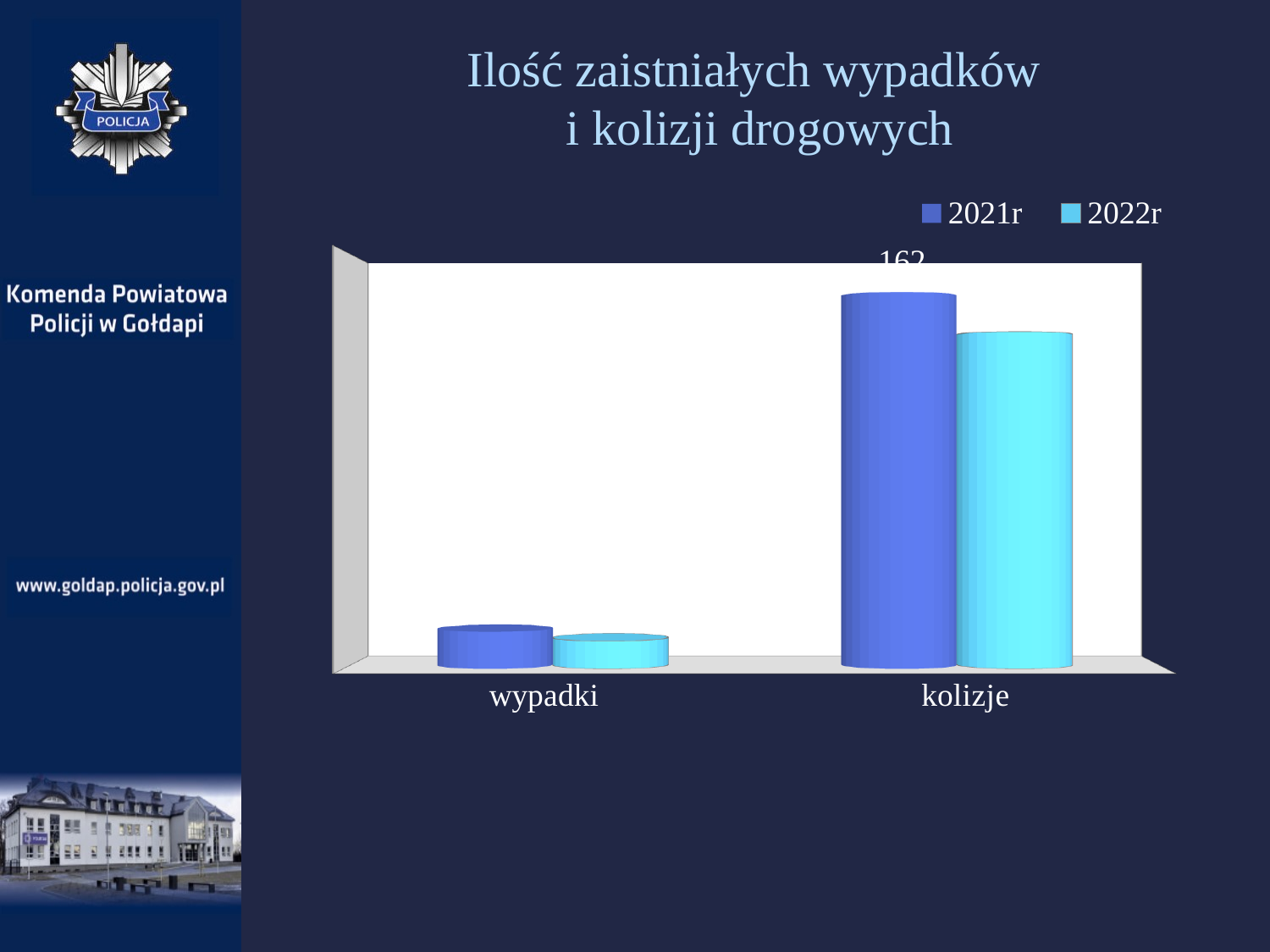
For wypadki, which year has the larger value, 2021r or 2022r? 2021r What is the title of the chart? Ilość zaistniałych wypadków i kolizji drogowych Is the 2022r value for kolizje larger or smaller than the 2021r value for wypadki? larger Which category has the highest bars in the chart? kolizje What are the two series listed in the chart legend? 2021r and 2022r How many series does the chart legend list? 2 How many categories are shown on the x axis of the chart? 2 Which category has the lowest bars in the chart? wypadki Which category labels appear on the x axis of the chart? wypadki and kolizje What kind of chart is shown on the slide? bar chart For kolizje, which year has the larger value, 2021r or 2022r? 2021r